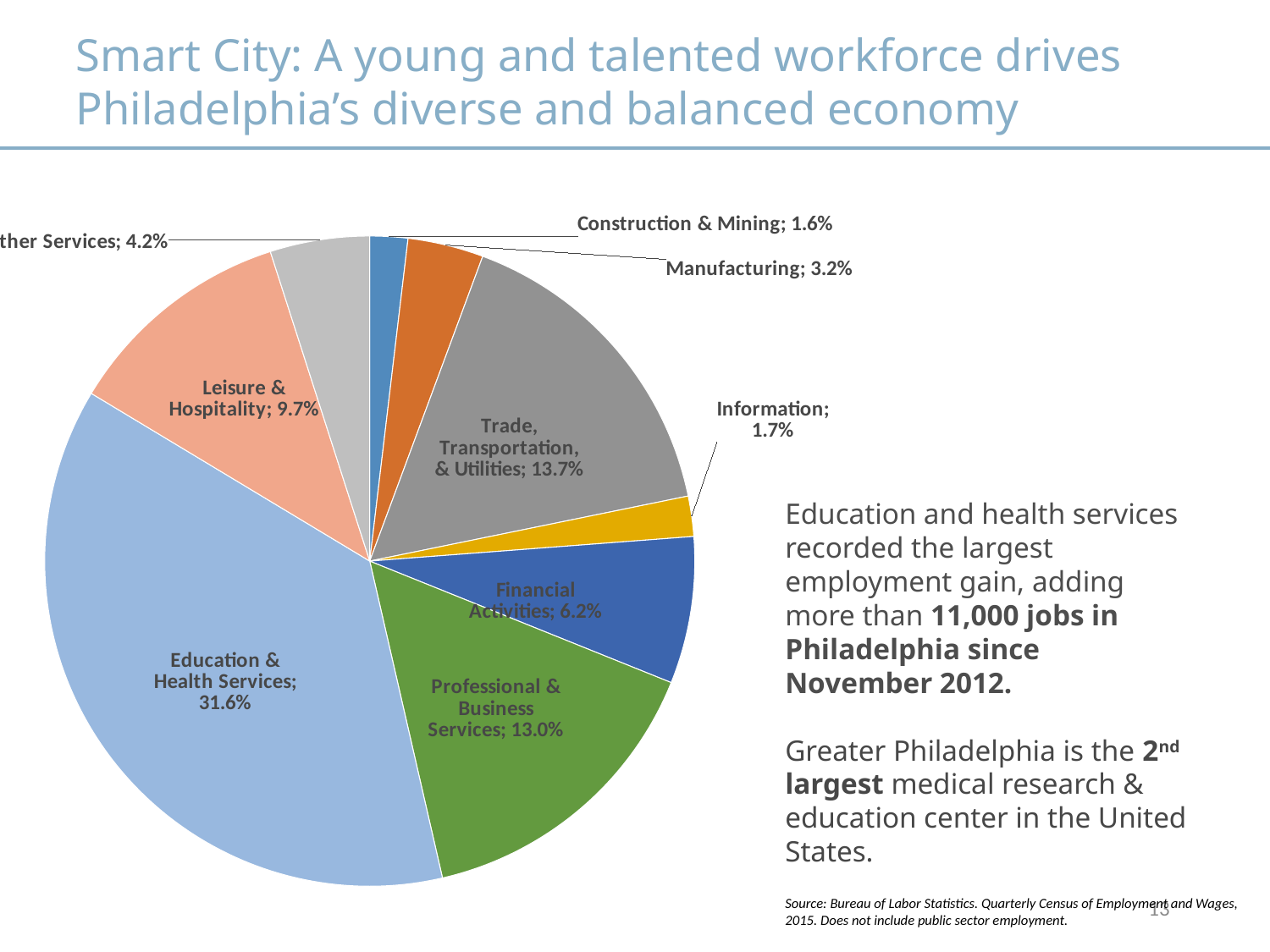
Which category has the smallest slice of the pie? Construction & Mining Which is larger, the share for Trade, Transportation, & Utilities or the share for Professional & Business Services? Trade, Transportation, & Utilities Which category has the largest slice of the pie? Education & Health Services What kind of chart is shown on the slide? pie chart What is the difference between the Education & Health Services share and the Professional & Business Services share? 18.6% What is the value shown for Trade, Transportation, & Utilities? 13.7% What is the value shown for Financial Activities? 6.2% What is the difference between the Leisure & Hospitality share and the Financial Activities share? 3.5% How many slices does the pie chart have? 9 What is the value shown for Manufacturing? 3.2% What share of the pie does Education & Health Services hold? 31.6% What is the value shown for Professional & Business Services? 13.0%